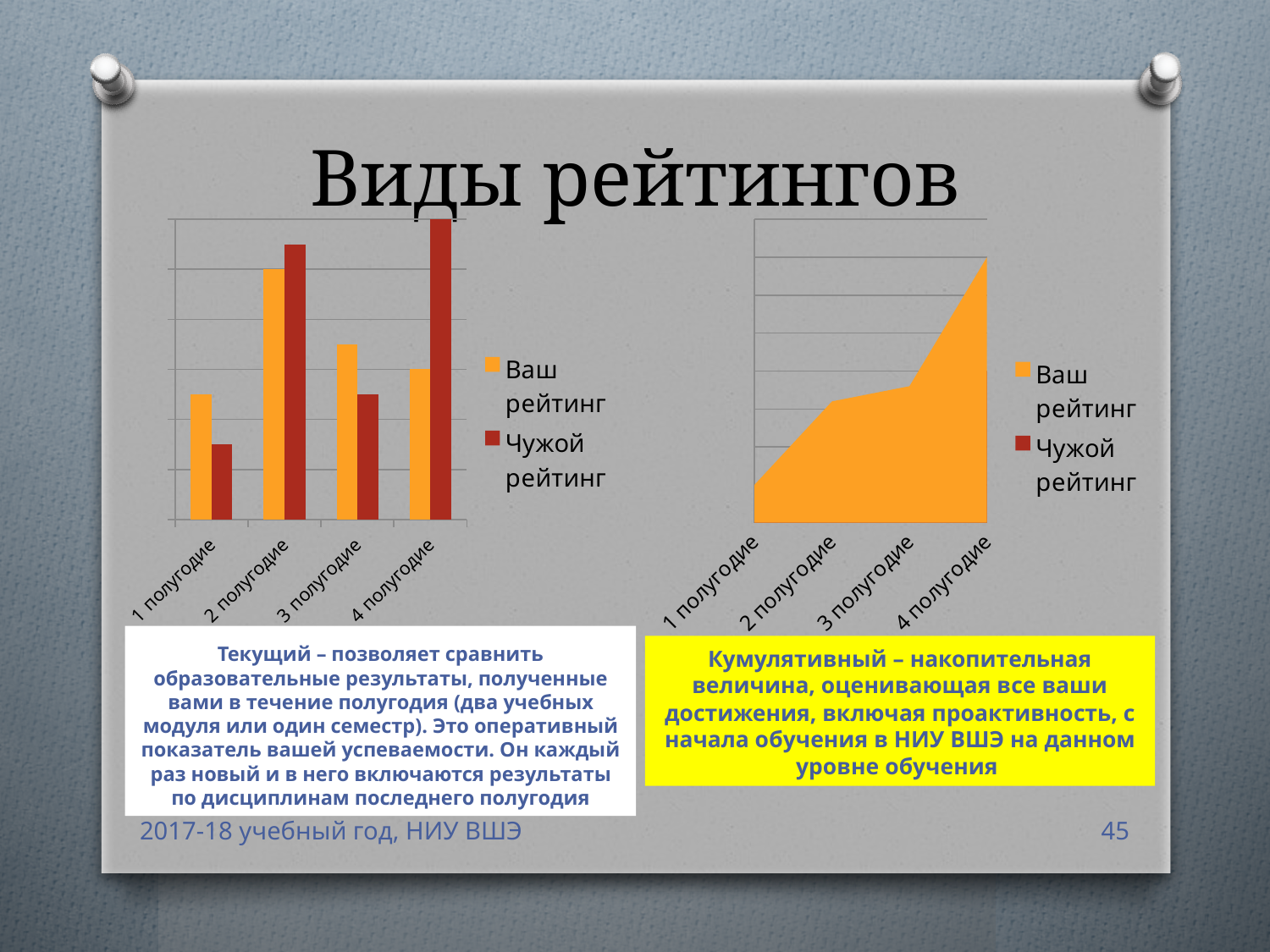
What colour represents Чужой рейтинг in the legend of the left bar chart? dark red How many series does the legend of the left bar chart list? 2 In the left bar chart, which category has the lowest value for Ваш рейтинг? 1 полугодие In the left bar chart, for 1 полугодие, which is larger: Ваш рейтинг or Чужой рейтинг? Ваш рейтинг What kind of chart is the chart on the left side of the slide? bar chart What kind of chart is the chart on the right side of the slide? area chart In the left bar chart, which category has the lowest value for Чужой рейтинг? 1 полугодие In the left bar chart, which category has the highest value for Ваш рейтинг? 2 полугодие In the left bar chart, for 4 полугодие, which is larger: Ваш рейтинг or Чужой рейтинг? Чужой рейтинг How many categories are shown on the x axis of the left bar chart? 4 In the right area chart, do the values for Ваш рейтинг rise or fall from 1 полугодие to 4 полугодие? rise In the left bar chart, which category has the highest value for Чужой рейтинг? 4 полугодие